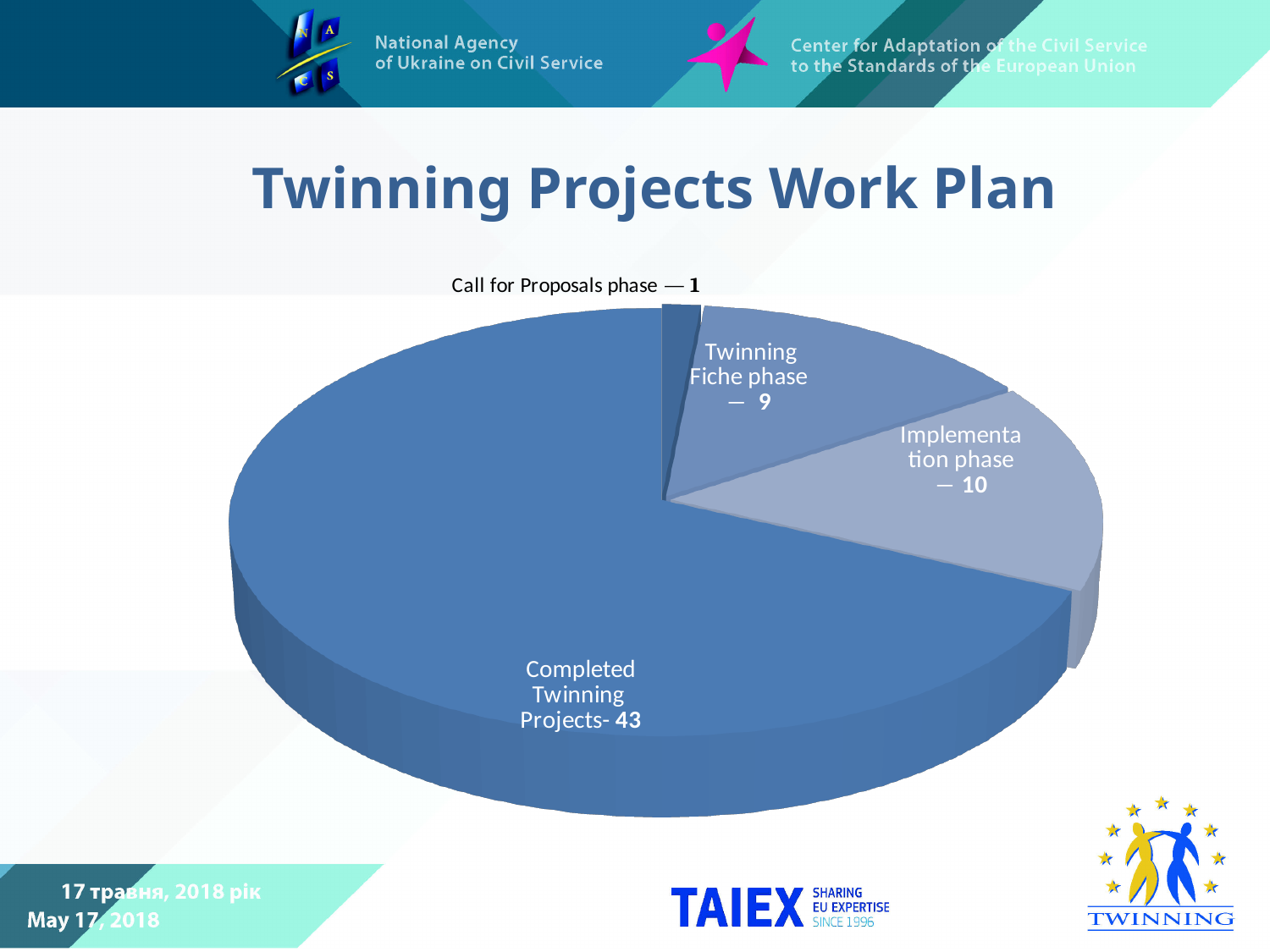
What is the value for the Implementation phase slice? 10 What is the title of the slide containing the pie chart? Twinning Projects Work Plan Which slice of the pie chart is the smallest? Call for Proposals phase Which is larger, the Implementation phase value or the Twinning Fiche phase value? Implementation phase What is the total of all four slices in the pie chart? 63 How many slices does the pie chart have? 4 What is the value for the Twinning Fiche phase slice? 9 What is the value for the Call for Proposals phase slice? 1 How many Completed Twinning Projects does the pie chart show? 43 What kind of chart is shown on the slide? Pie chart What is the difference between the Completed Twinning Projects value and the Implementation phase value? 33 Which slice of the pie chart is the largest? Completed Twinning Projects